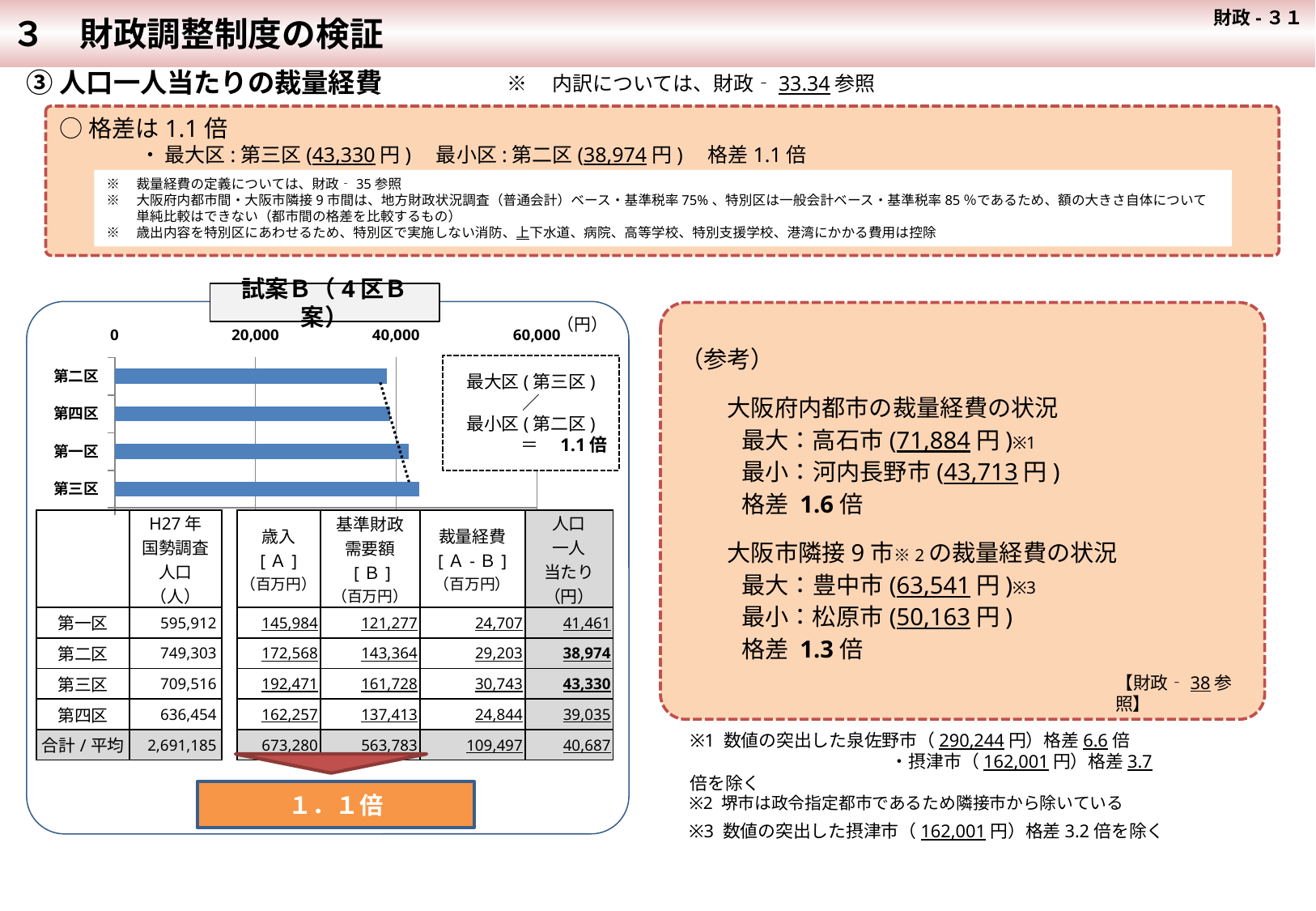
What kind of chart is shown on the left of the slide under the title 試案B（4区B案）? bar chart Which district has the shortest bar in the chart (the 最小区)? 第二区 Which has the larger 人口一人当たり value, 第三区 or 第一区? 第三区 According to the annotation box in the chart, what is the ratio of 最大区(第三区) to 最小区(第二区)? 1.1倍 How many districts (categories) are plotted in the bar chart? 4 What is the difference in yen between the 人口一人当たり values of 第三区 and 第二区? 4,356 Is the bar for 第二区 greater or less than 60,000? less Is the bar for 第三区 greater or less than 40,000? greater Which district has the longest bar in the chart? 第三区 What is the 人口一人当たり value for 第二区 in yen? 38,974 What is the 人口一人当たり value for 第三区 in yen? 43,330 What is the 人口一人当たり value for 第四区 in yen? 39,035